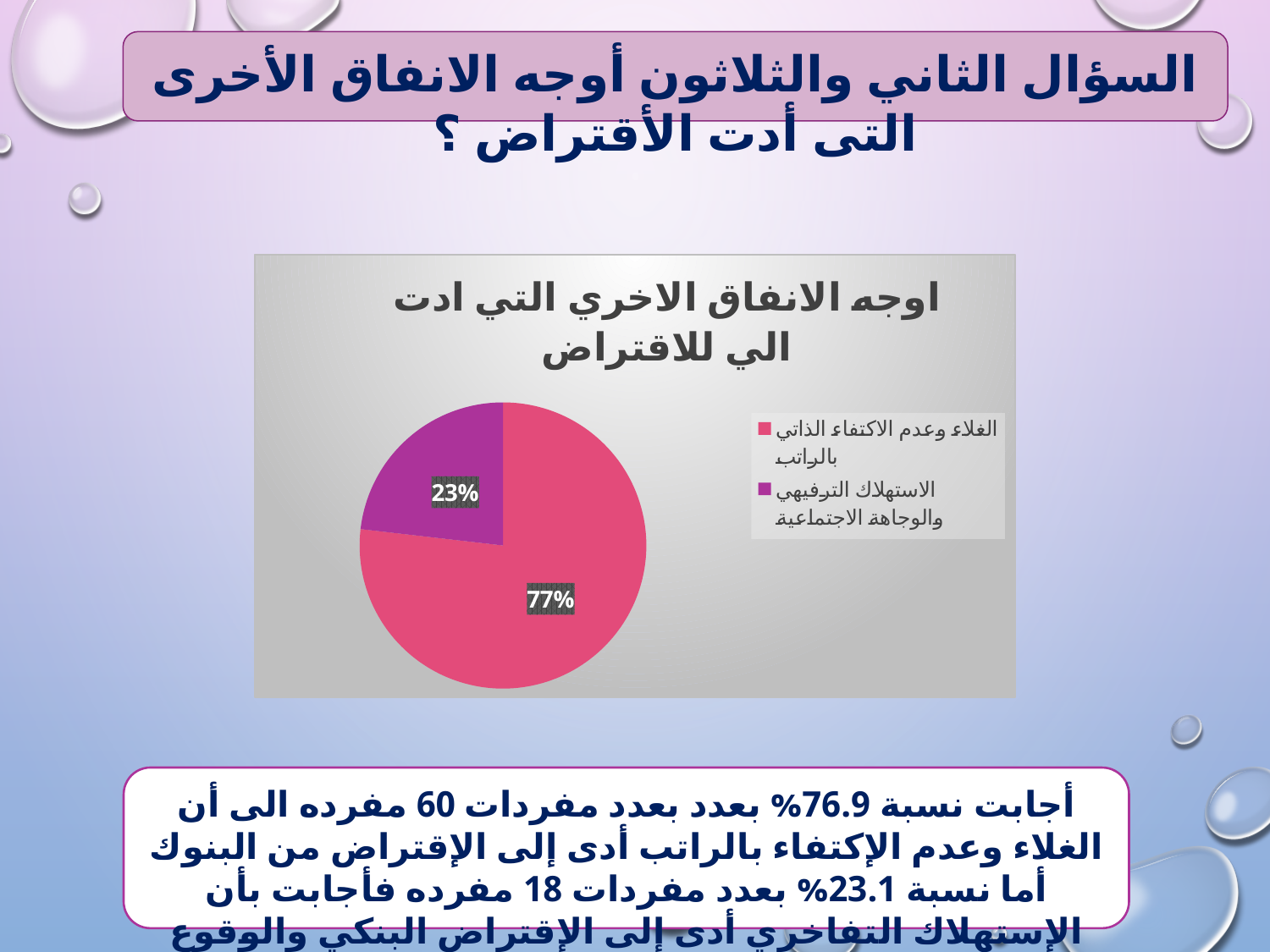
What percentage is shown for the slice 'الغلاء وعدم الاكتفاء الذاتي بالراتب'? 77% Which is larger: the share for 'الغلاء وعدم الاكتفاء الذاتي بالراتب' or the share for 'الاستهلاك الترفيهي والوجاهة الاجتماعية'? الغلاء وعدم الاكتفاء الذاتي بالراتب Which category has the smallest share of the pie? الاستهلاك الترفيهي والوجاهة الاجتماعية How many entries does the legend list? 2 What percentage is shown for the slice 'الاستهلاك الترفيهي والوجاهة الاجتماعية'? 23% What share of the pie does the purple slice represent? 23% What colour is the slice labelled 77%? pink What is the title of the chart? اوجه الانفاق الاخري التي ادت الي للاقتراض What type of chart is shown on the slide? pie chart How many slices does the pie chart have? 2 Which category has the largest share of the pie? الغلاء وعدم الاكتفاء الذاتي بالراتب What is the difference in percentage points between the two slices? 54